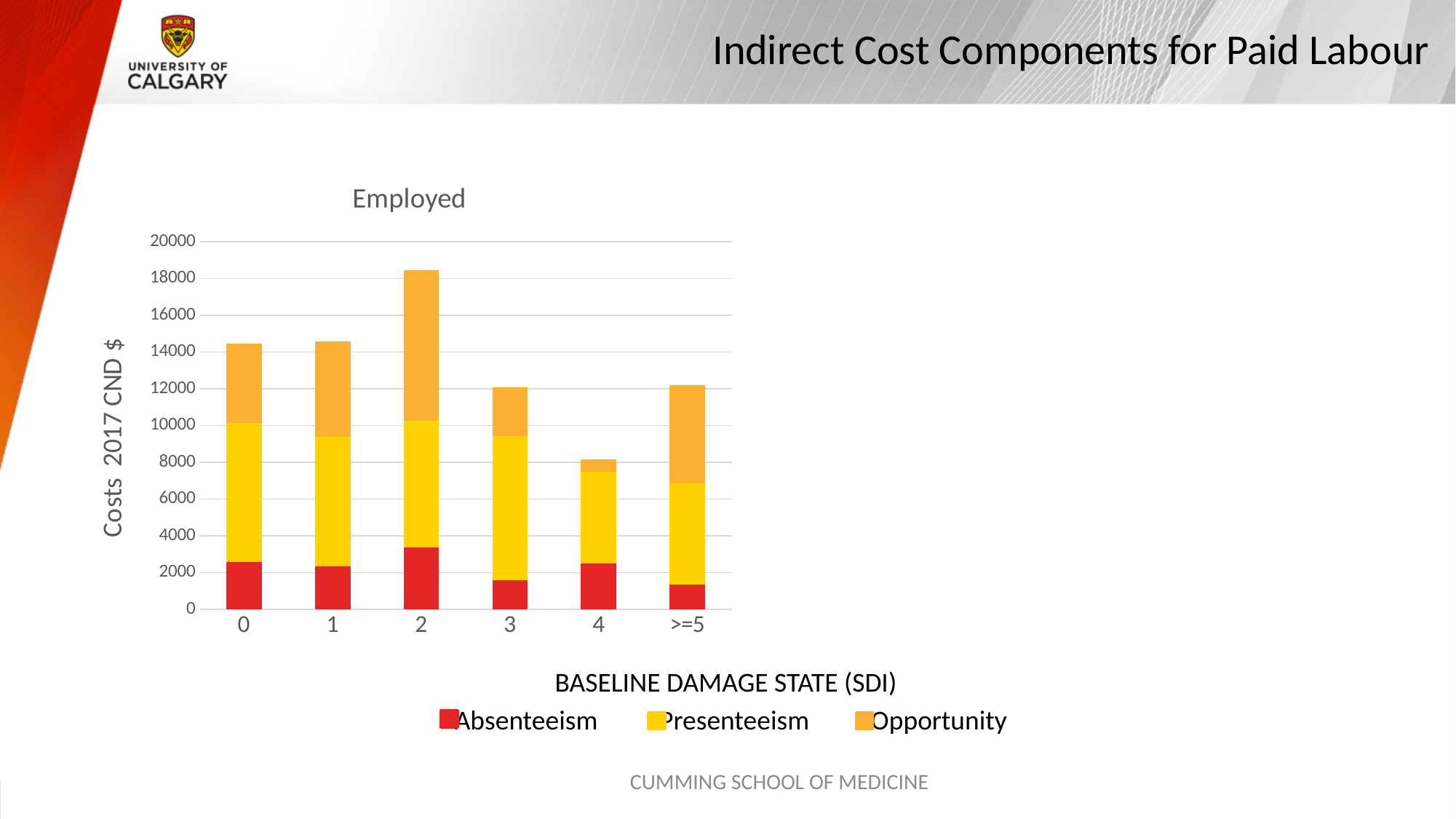
Which baseline damage state has the lowest total cost? 4 Which has a larger total cost, baseline damage state 2 or baseline damage state 4? 2 Is the total cost for baseline damage state 4 greater or less than 10000? less How many baseline damage state categories are shown on the x axis? 6 Is the total cost for baseline damage state 2 greater or less than 18000? greater Which baseline damage state has the highest total cost? 2 Which baseline damage state has the largest Absenteeism segment? 2 How many series does the legend list? 3 What type of chart is shown on the slide? Stacked bar chart Is the total cost for baseline damage state 0 greater or less than 14000? greater What is the title of the chart? Employed